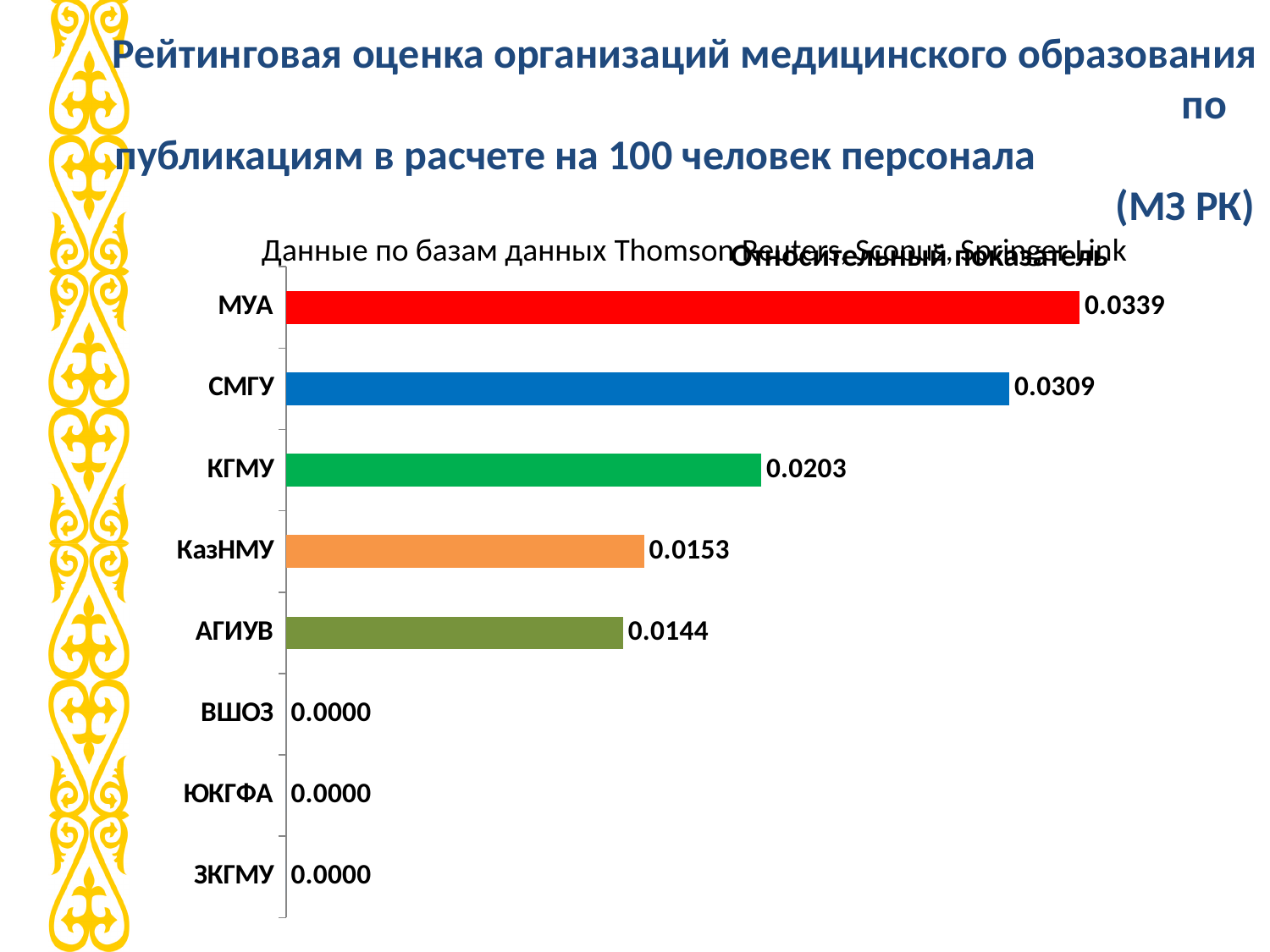
What is the value for ЗКГМУ? 0.0000 What is the difference between the values for КГМУ and КазНМУ? 0.0050 What is the value for КазНМУ? 0.0153 What is the value for СМГУ? 0.0309 Which organization has the highest value? МУА How many organizations are shown in the chart? 8 What is the value for МУА? 0.0339 What is the value for КГМУ? 0.0203 What is the difference between the values for МУА and СМГУ? 0.0030 What kind of chart is shown on the slide? Bar chart Which has a larger value, КазНМУ or АГИУВ? КазНМУ What is the value for АГИУВ? 0.0144